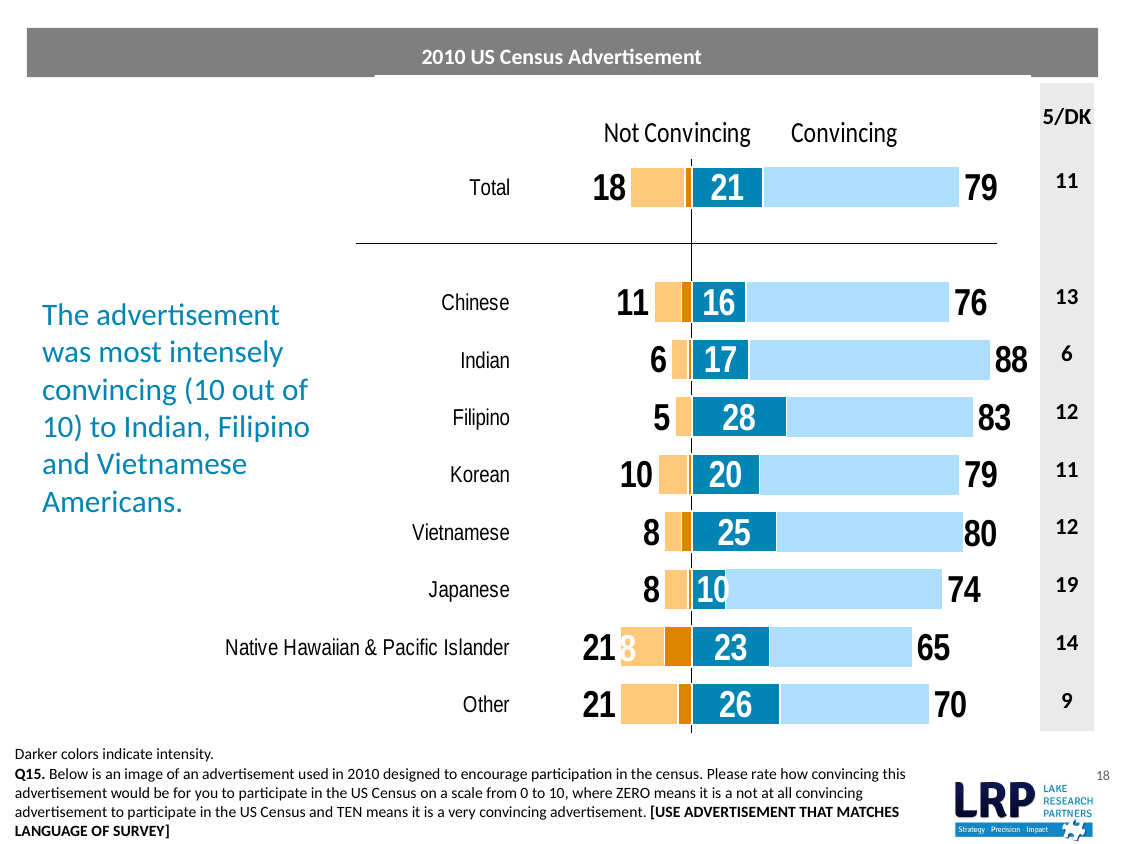
How many rows (including Total) are shown in the chart? 9 What is the difference between the Convincing values for Indian and Chinese respondents? 12 What kind of chart is shown on the slide? Bar chart What is the Convincing value for Indian respondents? 88 Which group has the lowest Convincing value? Native Hawaiian & Pacific Islander What is the 5/DK value for Japanese respondents? 19 Which group has the lowest Not Convincing value? Filipino Which group has the highest Convincing value? Indian What is the title of the chart? 2010 US Census Advertisement What is the Not Convincing value for the Total row? 18 Which has a larger Convincing value, Filipino or Japanese? Filipino What is the dark blue (most intense convincing) value for Filipino respondents? 28